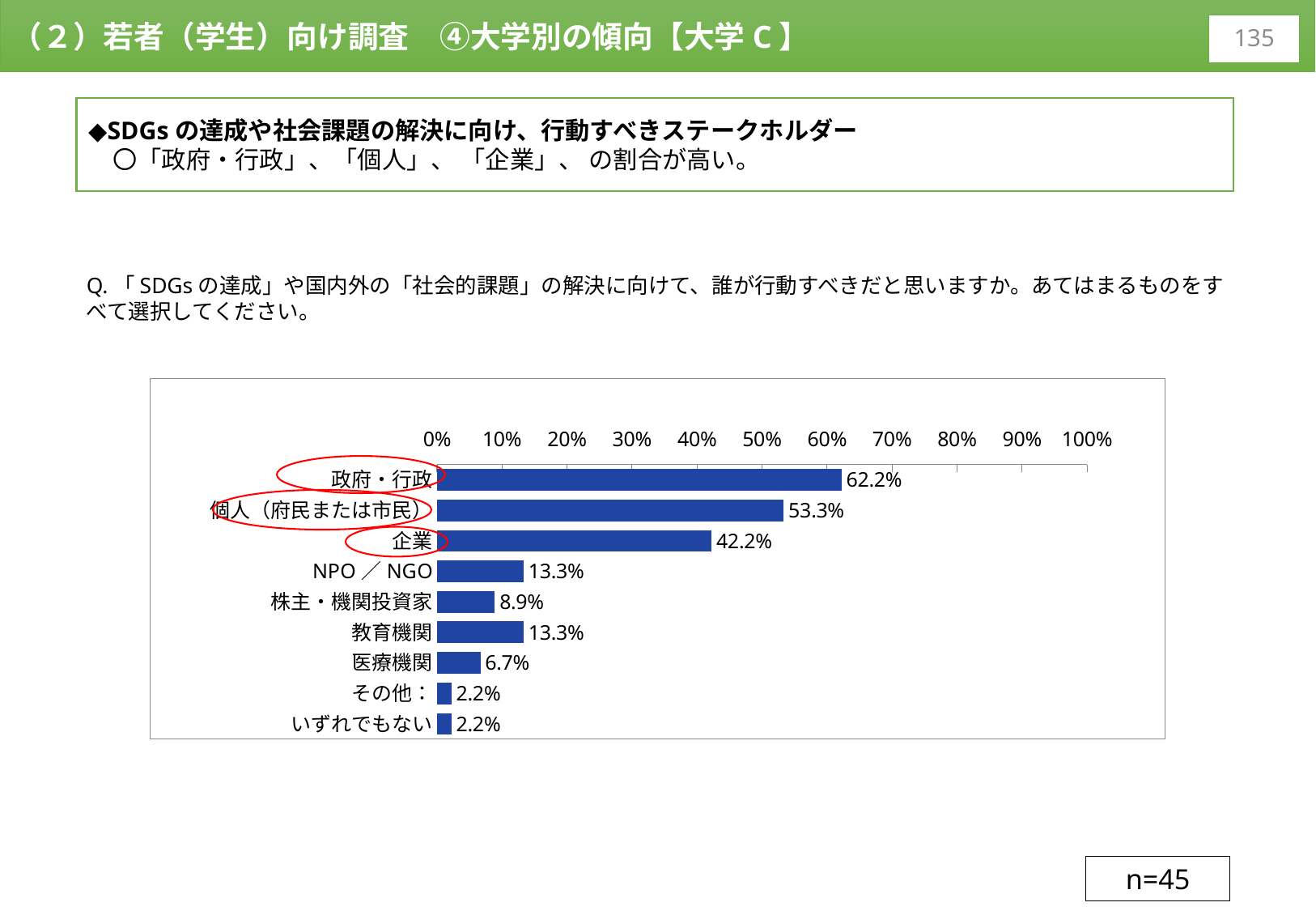
What is the value for 政府・行政? 62.2% How many categories are shown in the chart? 9 What is the difference between 政府・行政 and 個人（府民または市民）? 8.9% Which category has the highest value? 政府・行政 Which is larger, 個人（府民または市民） or 企業? 個人（府民または市民） What is the difference between 企業 and NPO／NGO? 28.9% What is the value for 企業? 42.2% What kind of chart is shown on the slide? Bar chart What is the sample size (n) shown on the slide? n=45 Which is larger, 株主・機関投資家 or 医療機関? 株主・機関投資家 What is the value for 医療機関? 6.7% What is the value for 株主・機関投資家? 8.9%